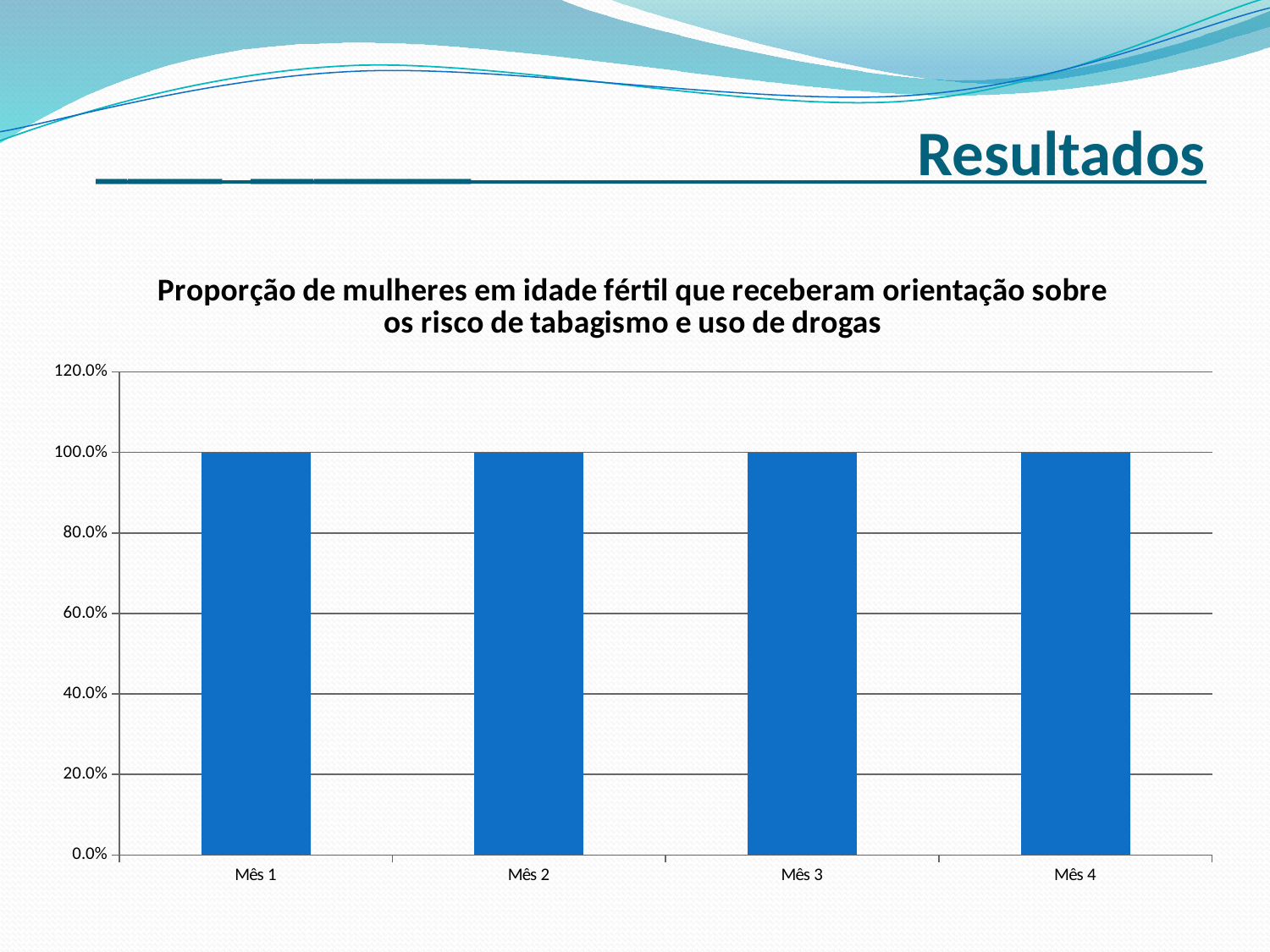
What type of chart is shown on the slide? bar chart How many categories (months) are shown on the x axis of the chart? 4 What is the highest value shown on the y axis of the chart? 120.0% What is the difference between the values for Mês 4 and Mês 1? 0.0% What is the value for Mês 3? 100.0% What is the value for Mês 4? 100.0% Is the value for Mês 1 greater or less than 120.0%? less What is the title of the chart? Proporção de mulheres em idade fértil que receberam orientação sobre os risco de tabagismo e uso de drogas What is the value for Mês 2? 100.0% Do the values rise, fall, or stay the same from Mês 1 to Mês 4? stay the same What is the value for Mês 1? 100.0% Is the value for Mês 3 greater or less than 80.0%? greater